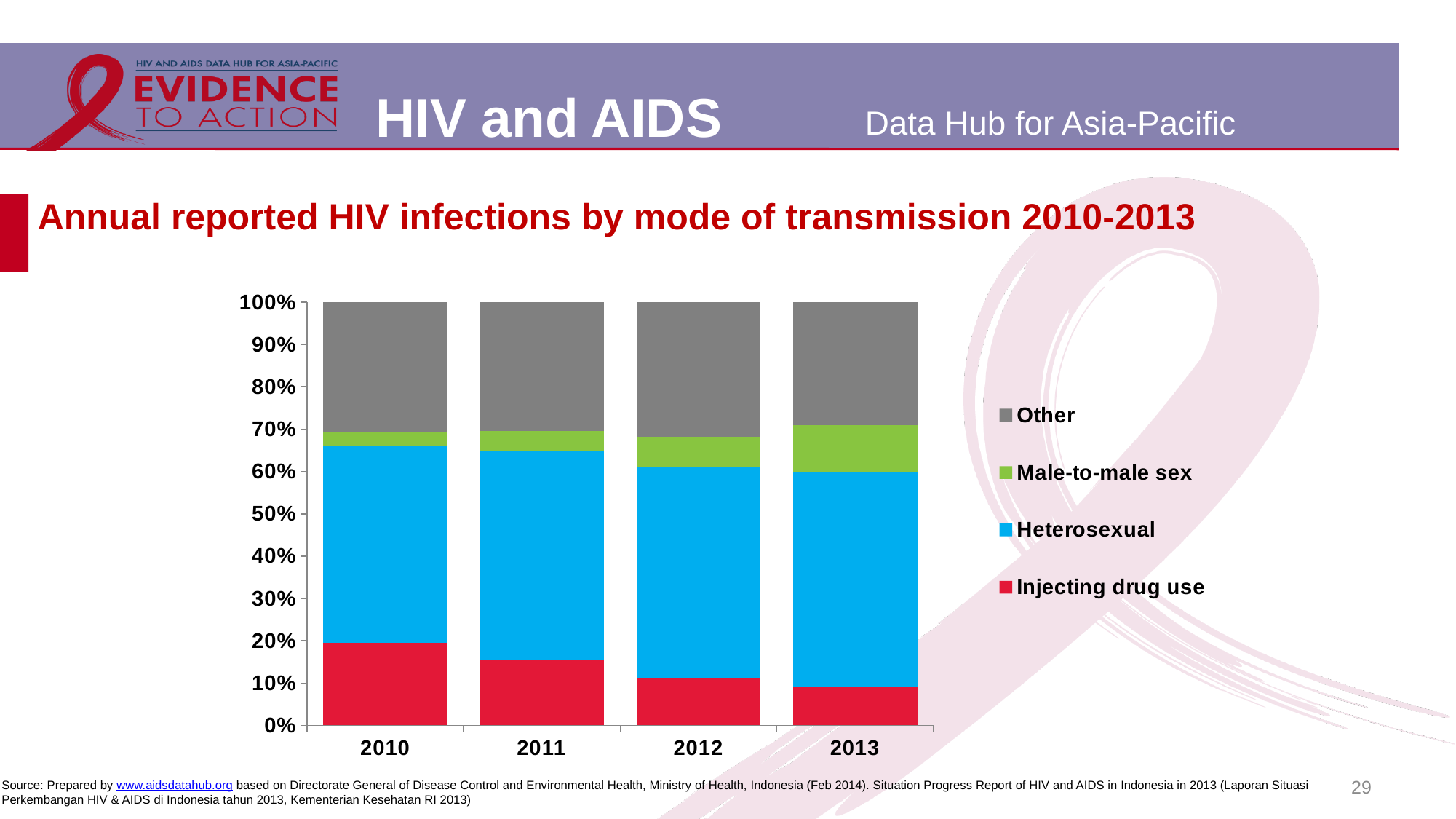
Which is larger in 2010: the Injecting drug use share or the Male-to-male sex share? Injecting drug use What does each stacked bar in the chart total? 100% How many years are shown on the x axis of the chart? 4 How many series does the chart's legend list? 4 In which year is the Male-to-male sex share the highest? 2013 Does the share of Injecting drug use rise or fall from 2010 to 2013? Fall Does the share of Male-to-male sex rise or fall from 2010 to 2013? Rise In which year is the Injecting drug use share the lowest? 2013 Is the Injecting drug use share in 2010 greater or less than 10%? greater What is the title of the chart on the slide? Annual reported HIV infections by mode of transmission 2010-2013 Which mode of transmission is shown in red in the chart? Injecting drug use What kind of chart is shown on the slide? Stacked bar chart